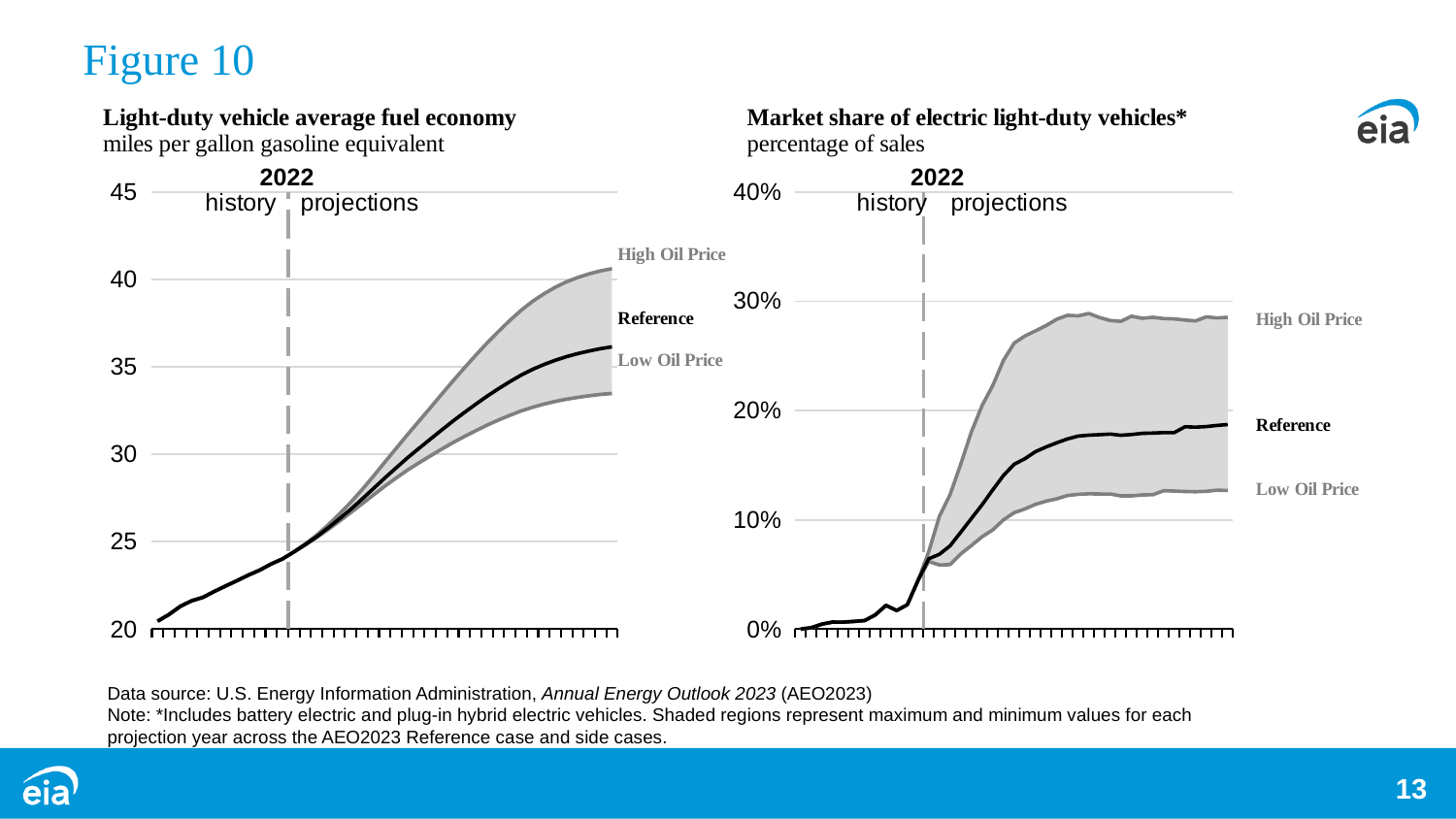
What kind of chart is the 'Market share of electric light-duty vehicles*' chart? line chart In the 'Light-duty vehicle average fuel economy' chart, is the Low Oil Price value at the end of the projection period greater or less than 35? less What kind of chart is the 'Light-duty vehicle average fuel economy' chart? line chart In the 'Light-duty vehicle average fuel economy' chart, is the Reference value at the end of the projection period greater or less than 35? greater In the 'Light-duty vehicle average fuel economy' chart, does the Reference line rise or fall over the projection period? rise In the 'Market share of electric light-duty vehicles*' chart, which is higher at the end of the projection period, High Oil Price or Low Oil Price? High Oil Price In the 'Market share of electric light-duty vehicles*' chart, is the Reference value at the end of the projection period greater or less than 20%? less In the 'Light-duty vehicle average fuel economy' chart, what unit is shown under the title? miles per gallon gasoline equivalent In the 'Market share of electric light-duty vehicles*' chart, which year separates history from projections? 2022 In the 'Light-duty vehicle average fuel economy' chart, how many labeled series (cases) are shown? 3